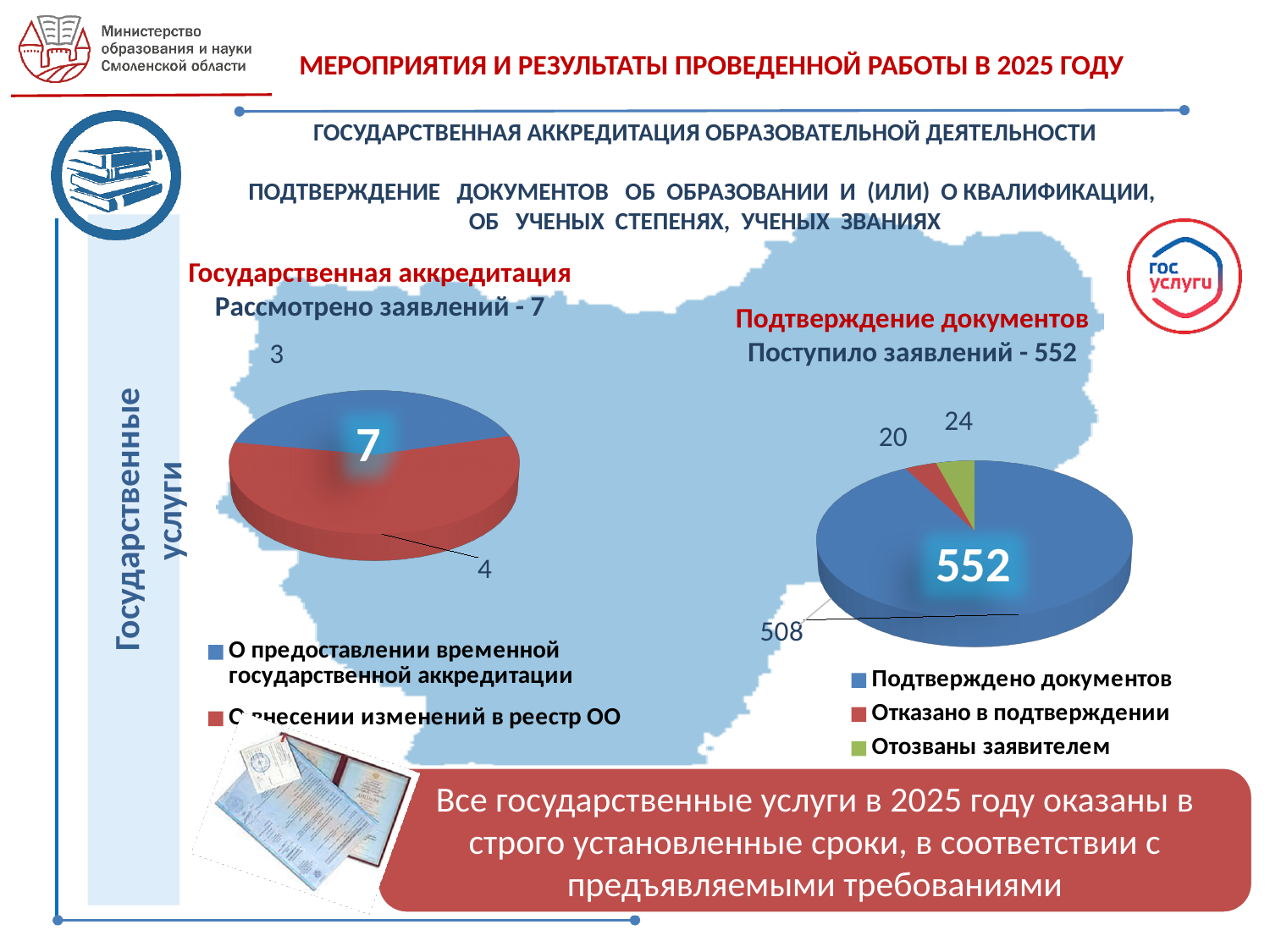
In the 'Подтверждение документов' chart, what is the difference between 'Подтверждено документов' and 'Отозваны заявителем'? 484 In the 'Государственная аккредитация' chart, which category has the larger value? О внесении изменений в реестр ОО In the 'Подтверждение документов' chart, what colour is the 'Отозваны заявителем' slice? green In the 'Подтверждение документов' chart, what is the value for 'Отказано в подтверждении'? 20 In the 'Государственная аккредитация' chart, what is the value for 'О внесении изменений в реестр ОО'? 4 In the 'Подтверждение документов' chart, what is the value for 'Подтверждено документов'? 508 How many categories does the legend of the 'Подтверждение документов' chart list? 3 In the 'Подтверждение документов' chart, what is the value for 'Отозваны заявителем'? 24 In the 'Государственная аккредитация' chart, what is the value for 'О предоставлении временной государственной аккредитации'? 3 In the 'Государственная аккредитация' chart, what is the total of the two slices? 7 What type of chart is used on the left for 'Государственная аккредитация'? pie chart In the 'Подтверждение документов' chart, which category has the smallest value? Отказано в подтверждении